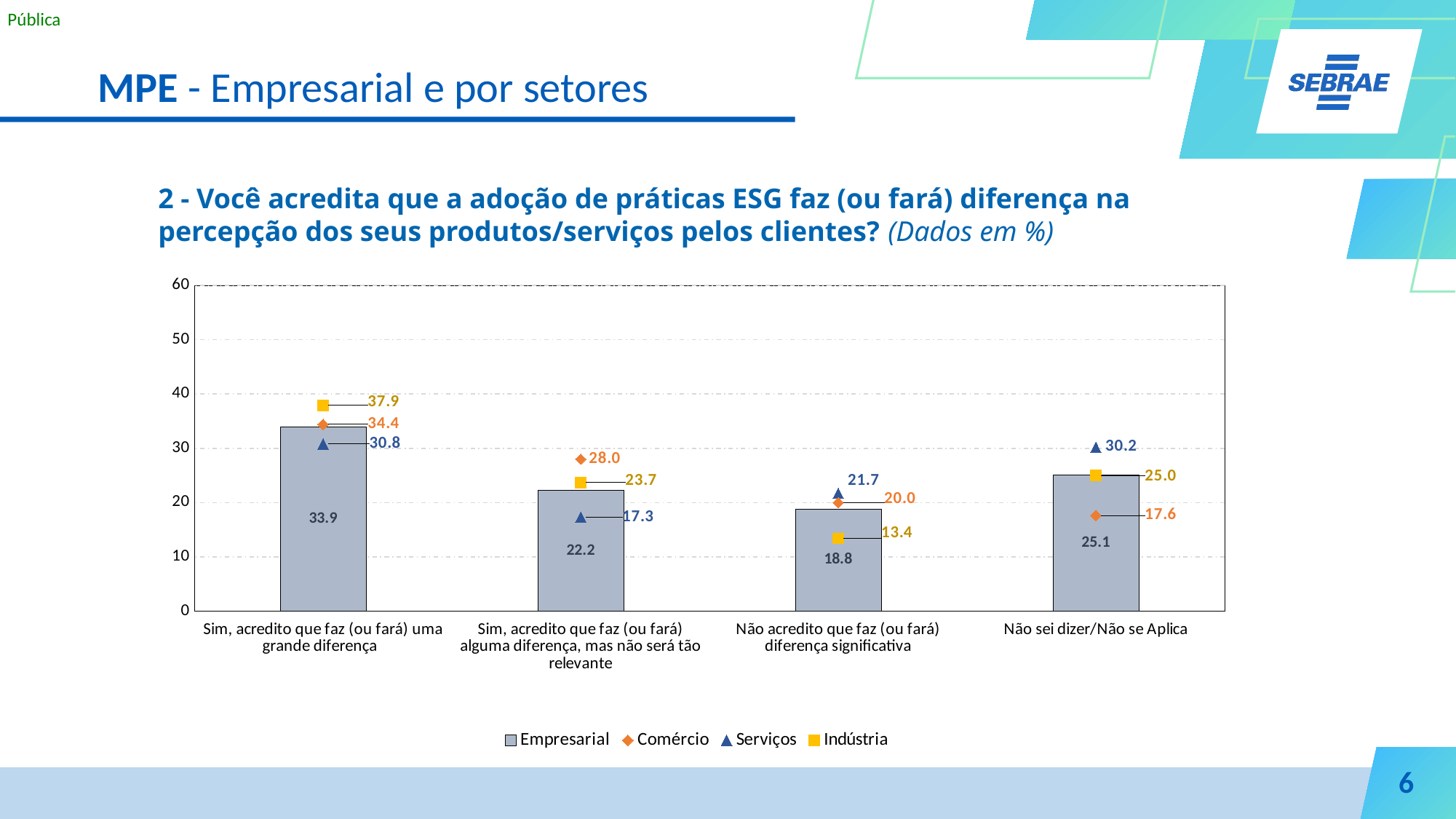
Which category has the highest Empresarial value? Sim, acredito que faz (ou fará) uma grande diferença How many categories are shown on the x axis? 4 Which category has the lowest Indústria value? Não acredito que faz (ou fará) diferença significativa How many series does the legend list? 4 Is the Empresarial value for "Sim, acredito que faz (ou fará) alguma diferença, mas não será tão relevante" greater or less than 30? less What is the difference between the Indústria and Serviços values for "Sim, acredito que faz (ou fará) uma grande diferença"? 7.1 What is the Indústria value for "Não acredito que faz (ou fará) diferença significativa"? 13.4 Which series is represented by the bars in the chart? Empresarial What is the Empresarial value for "Sim, acredito que faz (ou fará) uma grande diferença"? 33.9 What is the Serviços value for "Não sei dizer/Não se Aplica"? 30.2 What is the Comércio value for "Sim, acredito que faz (ou fará) alguma diferença, mas não será tão relevante"? 28.0 For "Não sei dizer/Não se Aplica", which is larger: the Serviços value or the Comércio value? Serviços